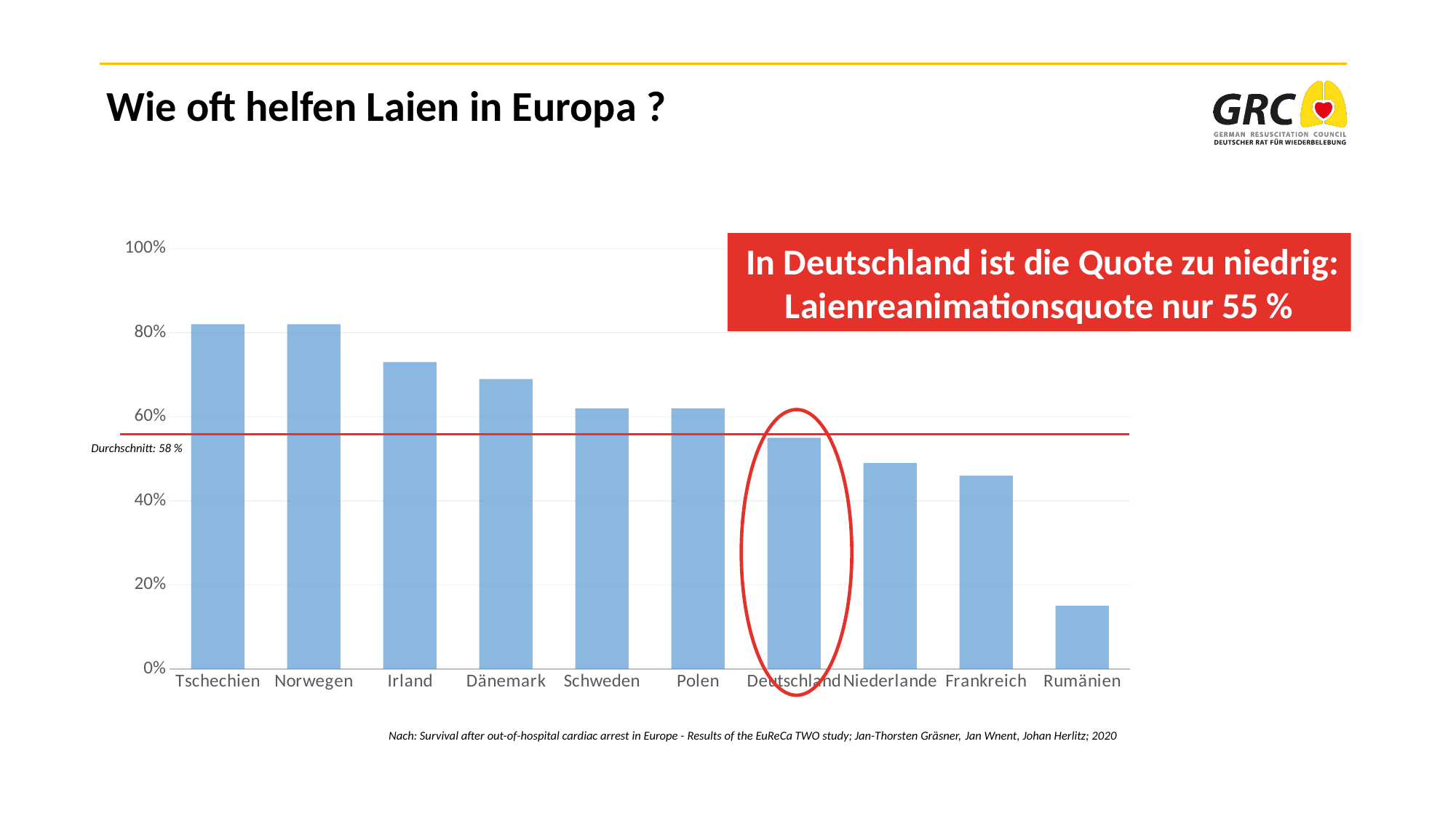
How many countries are shown on the x axis of the chart? 10 Which has the larger value, Dänemark or Frankreich? Dänemark Is the value for Rumänien greater or less than 20%? less Is the value for Irland greater or less than 60%? greater What average value (Durchschnitt) is marked by the horizontal red line in the chart? 58 % Is the value for Niederlande greater or less than 60%? less Which has the larger value, Irland or Niederlande? Irland What kind of chart is shown on the slide? bar chart Do the values generally rise or fall from left to right along the x axis? fall What is the value for Deutschland according to the slide? 55 % Which country has the lowest value in the chart? Rumänien